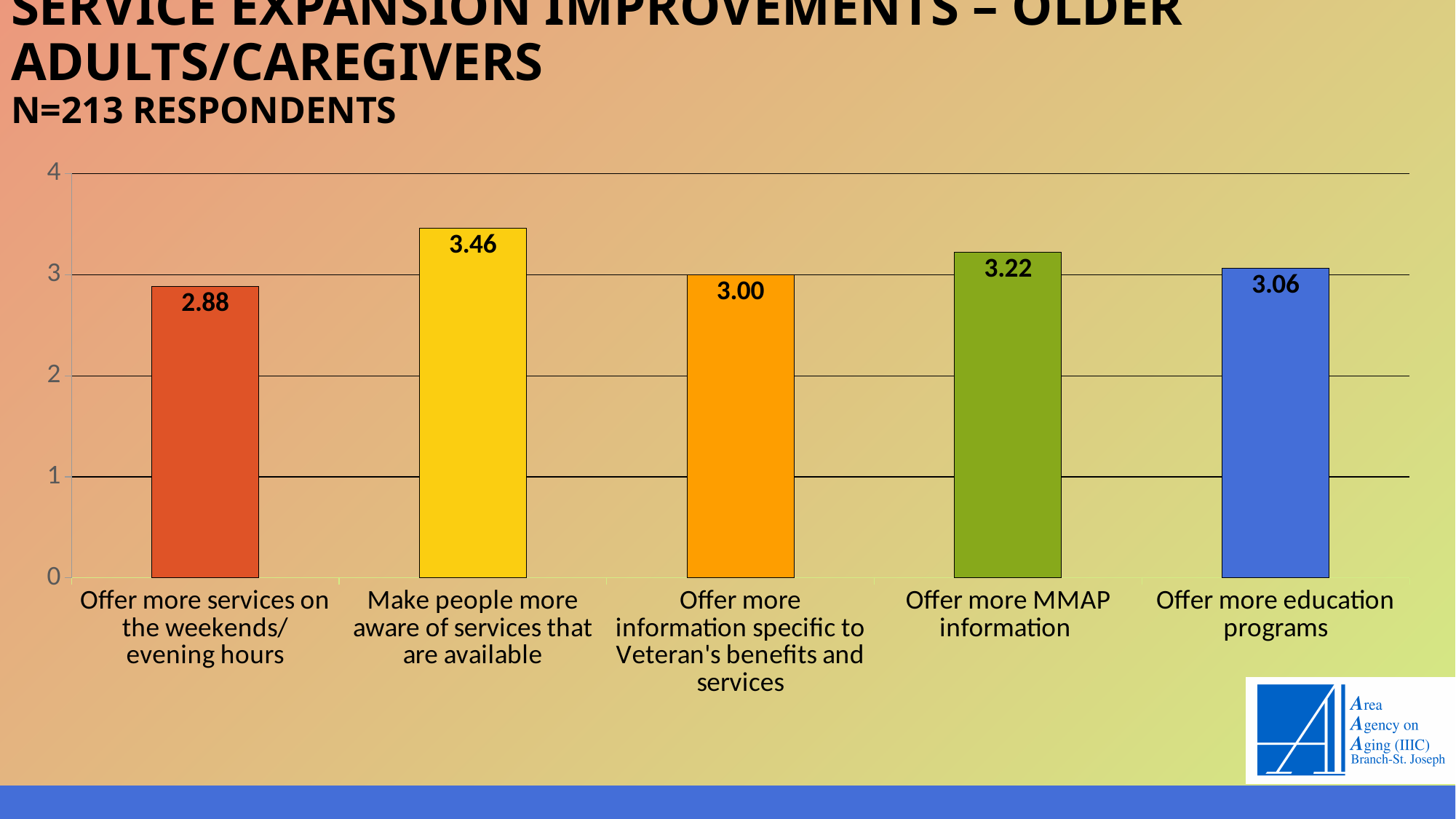
How many categories are shown in the chart? 5 What is the value for "Offer more education programs"? 3.06 Which is larger: the value for "Offer more MMAP information" or the value for "Offer more education programs"? Offer more MMAP information What is the difference between the values for "Make people more aware of services that are available" and "Offer more MMAP information"? 0.24 Which category has the highest value? Make people more aware of services that are available What is the value for "Offer more services on the weekends/ evening hours"? 2.88 What is the value for "Make people more aware of services that are available"? 3.46 What colour is the bar for "Offer more information specific to Veteran's benefits and services"? orange What is the value for "Offer more MMAP information"? 3.22 Is the value for "Offer more services on the weekends/ evening hours" greater or less than 3? less Which category has the lowest value? Offer more services on the weekends/ evening hours What kind of chart is shown on the slide? bar chart